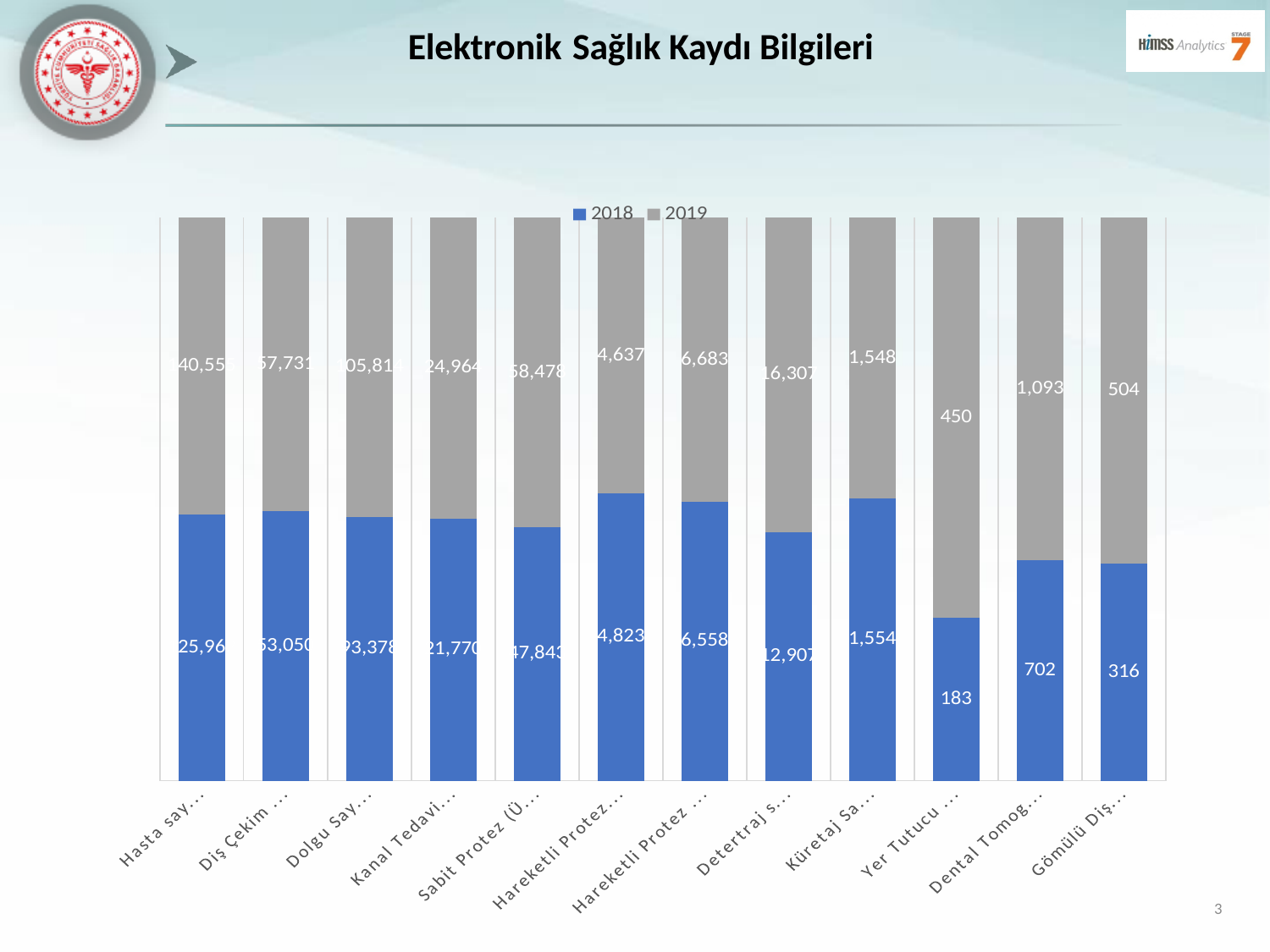
What are the two entries in the chart legend? 2018 and 2019 What is the difference between the 2019 and 2018 values for Gömülü Diş...? 188 What is the 2019 value for Dental Tomog...? 1,093 What is the sum of the 2018 and 2019 values for Yer Tutucu? 633 How many series does the legend list? 2 What kind of chart is shown on the slide? Stacked bar chart For Yer Tutucu, which year has the larger value, 2018 or 2019? 2019 How many categories are plotted along the x axis? 12 What is the 2018 value for Yer Tutucu? 183 What is the 2019 value for Yer Tutucu? 450 What is the difference between the 2019 and 2018 values for Dental Tomog...? 391 What is the 2018 value for Gömülü Diş...? 316